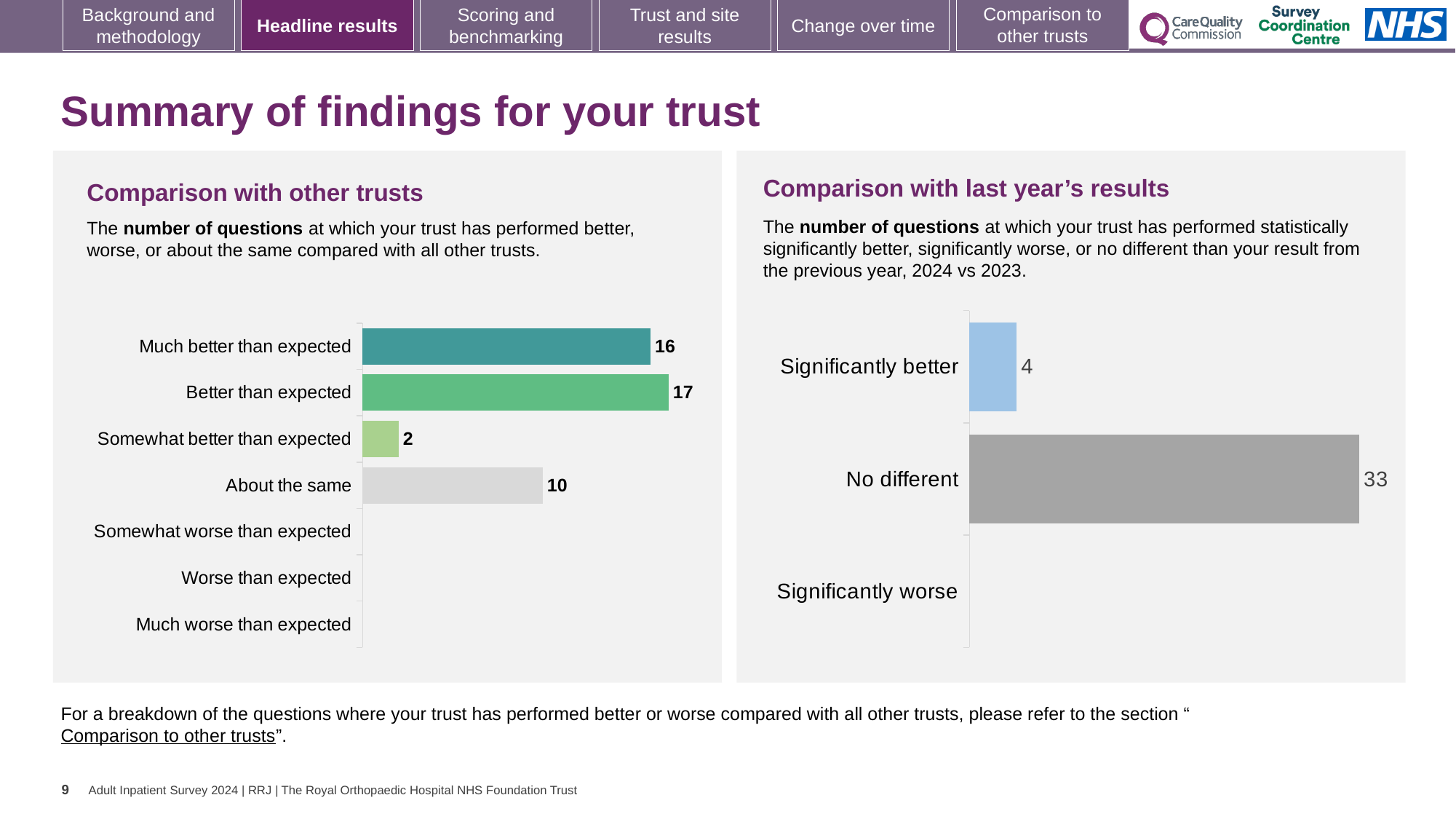
How many categories are listed on the y axis of the 'Comparison with last year's results' chart? 3 In the 'Comparison with other trusts' chart, how many questions are 'Better than expected'? 17 How many categories are listed on the y axis of the 'Comparison with other trusts' chart? 7 In the 'Comparison with other trusts' chart, which category has the highest value? Better than expected In the 'Comparison with other trusts' chart, how many questions are 'Much better than expected'? 16 In the 'Comparison with other trusts' chart, what is the difference between 'Better than expected' and 'Somewhat better than expected'? 15 In the 'Comparison with last year's results' chart, what is the difference between 'No different' and 'Significantly better'? 29 What type of chart is the 'Comparison with last year's results' chart? Bar chart In the 'Comparison with other trusts' chart, which is larger: 'About the same' or 'Somewhat better than expected'? About the same In the 'Comparison with last year's results' chart, how many questions are 'Significantly better'? 4 In the 'Comparison with last year's results' chart, how many questions are 'No different'? 33 In the 'Comparison with other trusts' chart, how many questions are 'About the same'? 10